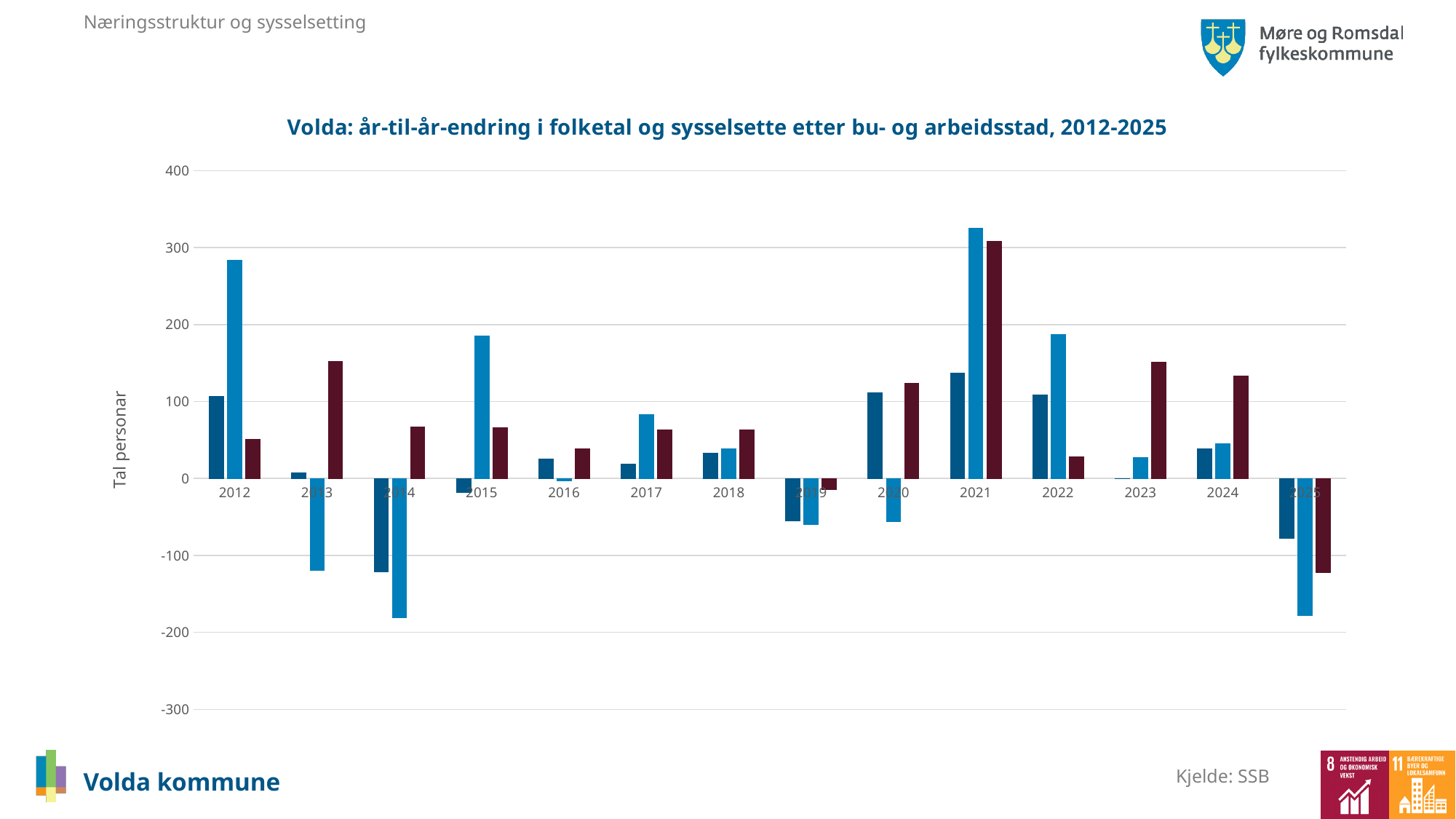
Is the value of the light blue bar for 2012 greater or less than 200? greater What kind of chart is shown on the slide? bar chart In which year is the light blue bar the highest? 2021 How many years are shown along the x axis of the chart? 14 Is the value of the dark red bar for 2025 greater or less than -100? less Is the value of the light blue bar for 2021 greater or less than 300? greater In which year is the dark red bar the lowest? 2025 Which is larger, the light blue bar for 2015 or the light blue bar for 2017? 2015 In which year is the dark red bar the highest? 2021 What is the title of the chart? Volda: år-til-år-endring i folketal og sysselsette etter bu- og arbeidsstad, 2012-2025 What is the label on the vertical axis of the chart? Tal personar